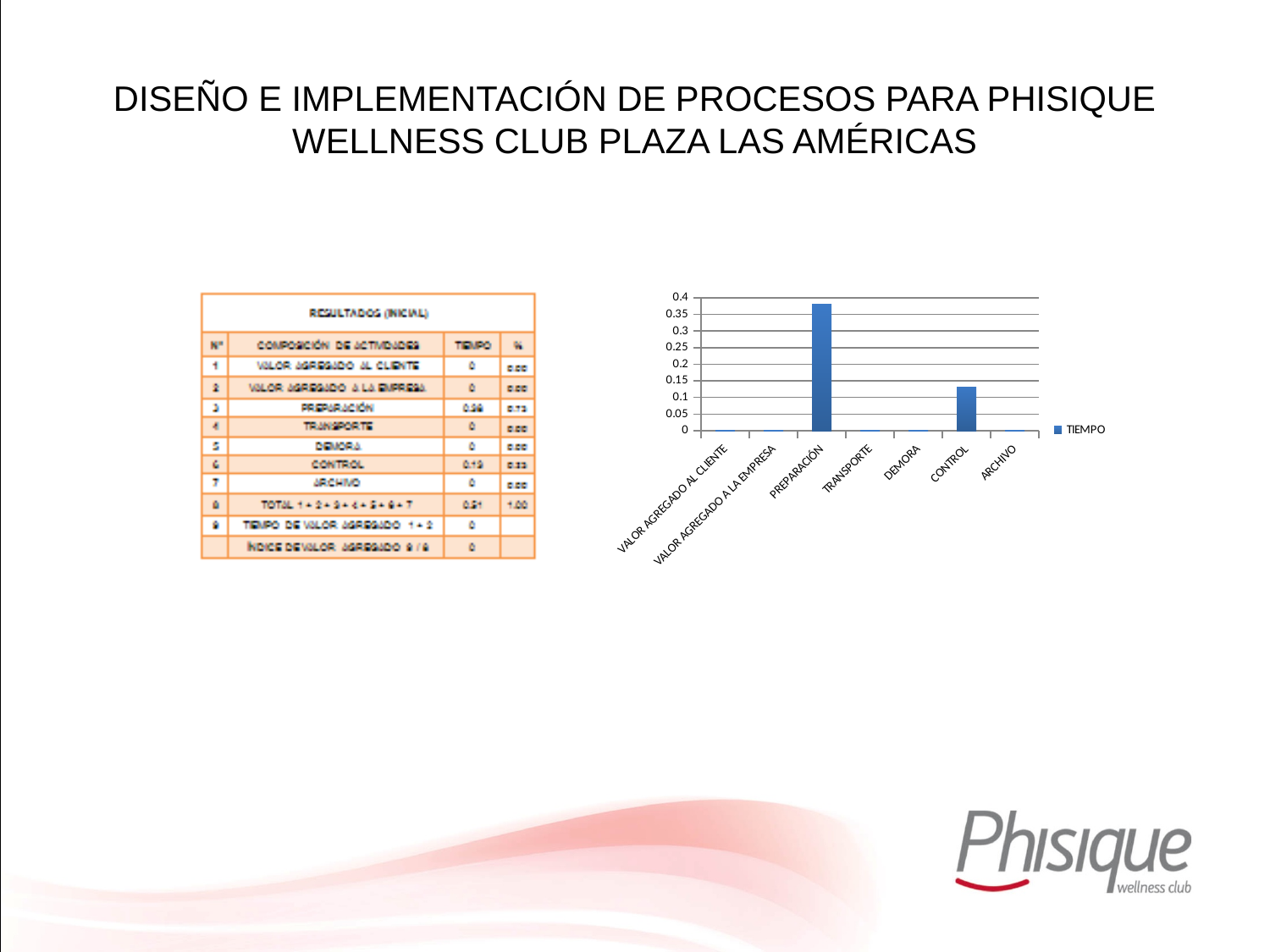
What kind of chart is shown on the slide? bar chart Which is larger, the value for PREPARACIÓN or the value for CONTROL? PREPARACIÓN Is the value for CONTROL greater or less than 0.1? greater What is the highest value shown on the y axis of the chart? 0.4 How many categories are shown on the x axis of the chart? 7 Is the value for PREPARACIÓN greater or less than 0.3? greater Which is larger, the value for CONTROL or the value for DEMORA? CONTROL Is the value for CONTROL greater or less than 0.2? less What is the name of the series shown in the chart legend? TIEMPO How many series does the chart legend list? 1 Which category has the highest value in the chart? PREPARACIÓN